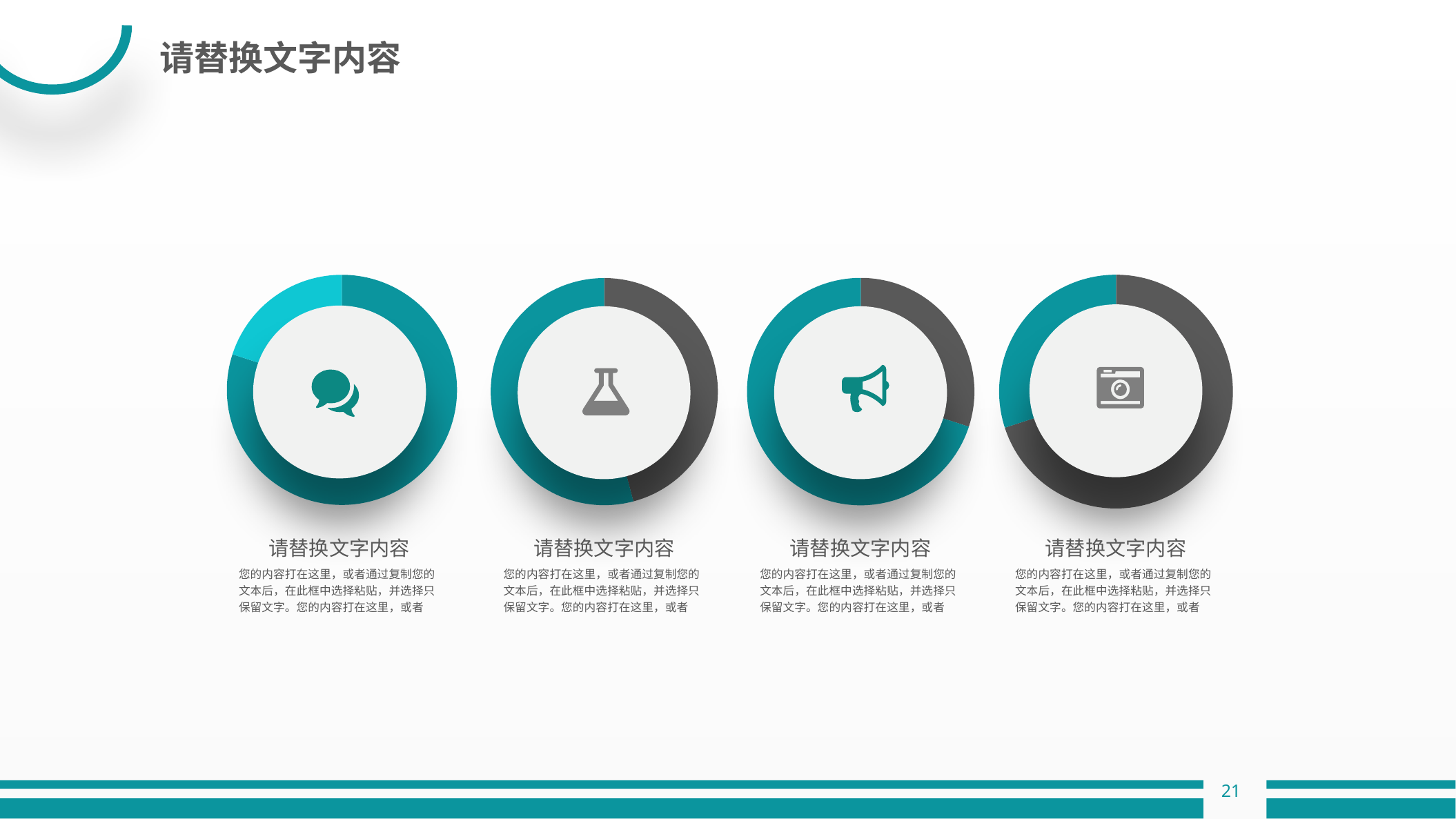
What icon is shown in the centre of the second donut chart from the left? A flask In the second donut chart from the left, which slice is larger, the teal one or the dark grey one? The dark grey one In the rightmost donut chart, which slice is larger, the teal one or the dark grey one? The dark grey one What kind of chart is the leftmost chart on the slide? Pie (donut) chart How many slices does the second donut chart from the left have? 2 In the third donut chart from the left, which slice is larger, the teal one or the dark grey one? The teal one Do any of the donut charts on the slide display data labels with values? No How many donut charts are shown on the slide? 4 Which of the four donut charts has the largest teal slice? The leftmost chart Which of the four donut charts has the smallest teal slice? The rightmost chart